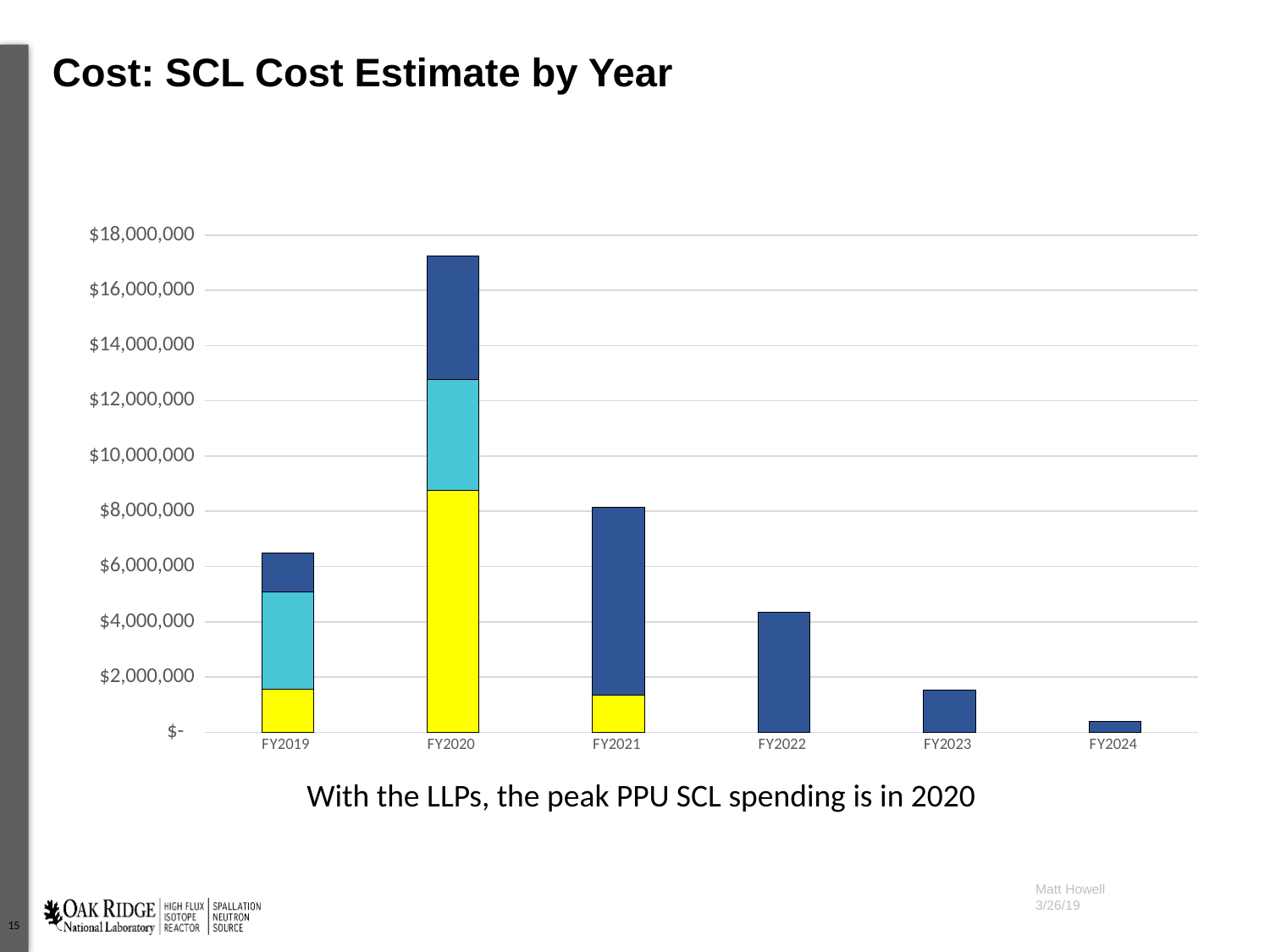
Which fiscal year has the lowest total bar in the chart? FY2024 Is the total value for FY2019 greater or less than $6,000,000? greater From FY2020 to FY2024, do the total bar values rise or fall? Fall Which has the larger total bar, FY2021 or FY2022? FY2021 Is the value for FY2023 greater or less than $2,000,000? less Is the total value for FY2020 greater or less than $16,000,000? greater Which fiscal year has the highest total bar in the chart? FY2020 How many fiscal years are shown on the x axis of the chart? 6 What kind of chart is shown on the slide? Stacked bar chart What is the title of the slide containing the chart? Cost: SCL Cost Estimate by Year